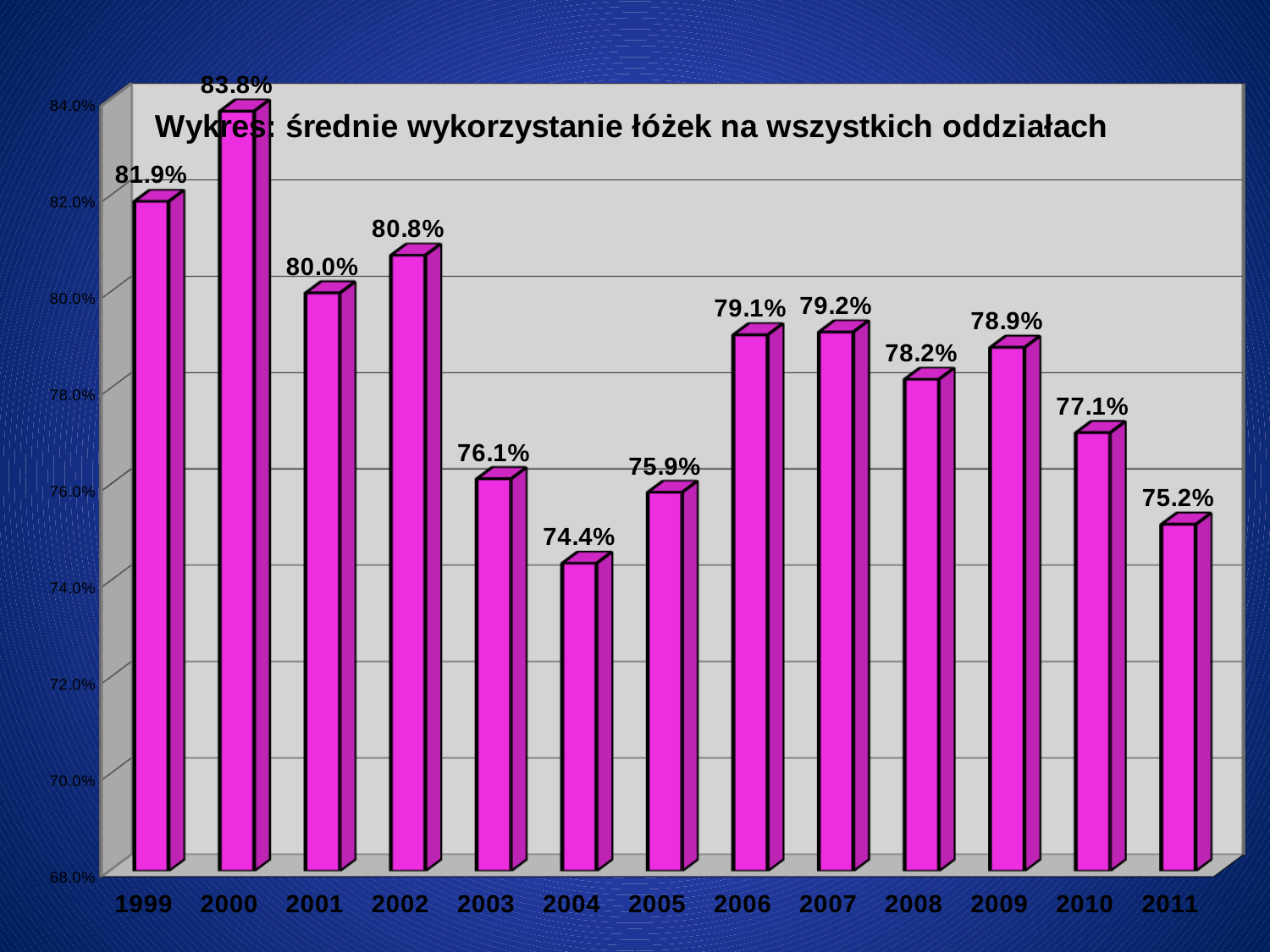
Is the value for 2010 greater or less than 78.0%? less What is the difference between the values for 1999 and 2011? 6.7% What is the value for 2008? 78.2% How many years are shown on the x axis? 13 What is the value for 2004? 74.4% What is the title of the chart? Wykres: średnie wykorzystanie łóżek na wszystkich oddziałach Do the values rise or fall from 2000 to 2004? fall Which is larger, the value for 2002 or the value for 2009? 2002 Which year has the lowest value? 2004 What is the value for 2000? 83.8% Which year has the highest value? 2000 What kind of chart is this? bar chart